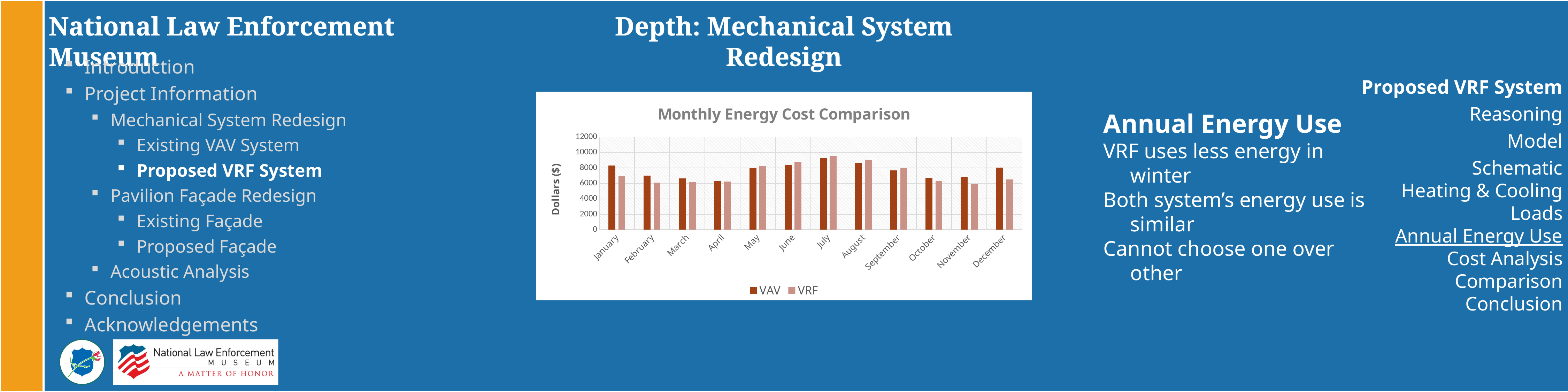
What is the label of the vertical axis of the chart? Dollars ($) Is the VRF value for November greater or less than 8000? less Which month has the highest VRF value in the chart? July Is the VAV value for January greater or less than 8000? greater Which month has the lowest VRF value in the chart? November What is the title of the chart? Monthly Energy Cost Comparison Which month has the highest VAV value in the chart? July Do the VAV values rise or fall from January to April? fall How many series does the chart's legend list? 2 How many months are plotted along the x axis of the chart? 12 What kind of chart is shown on the slide? bar chart In December, which is larger, the VAV value or the VRF value? VAV